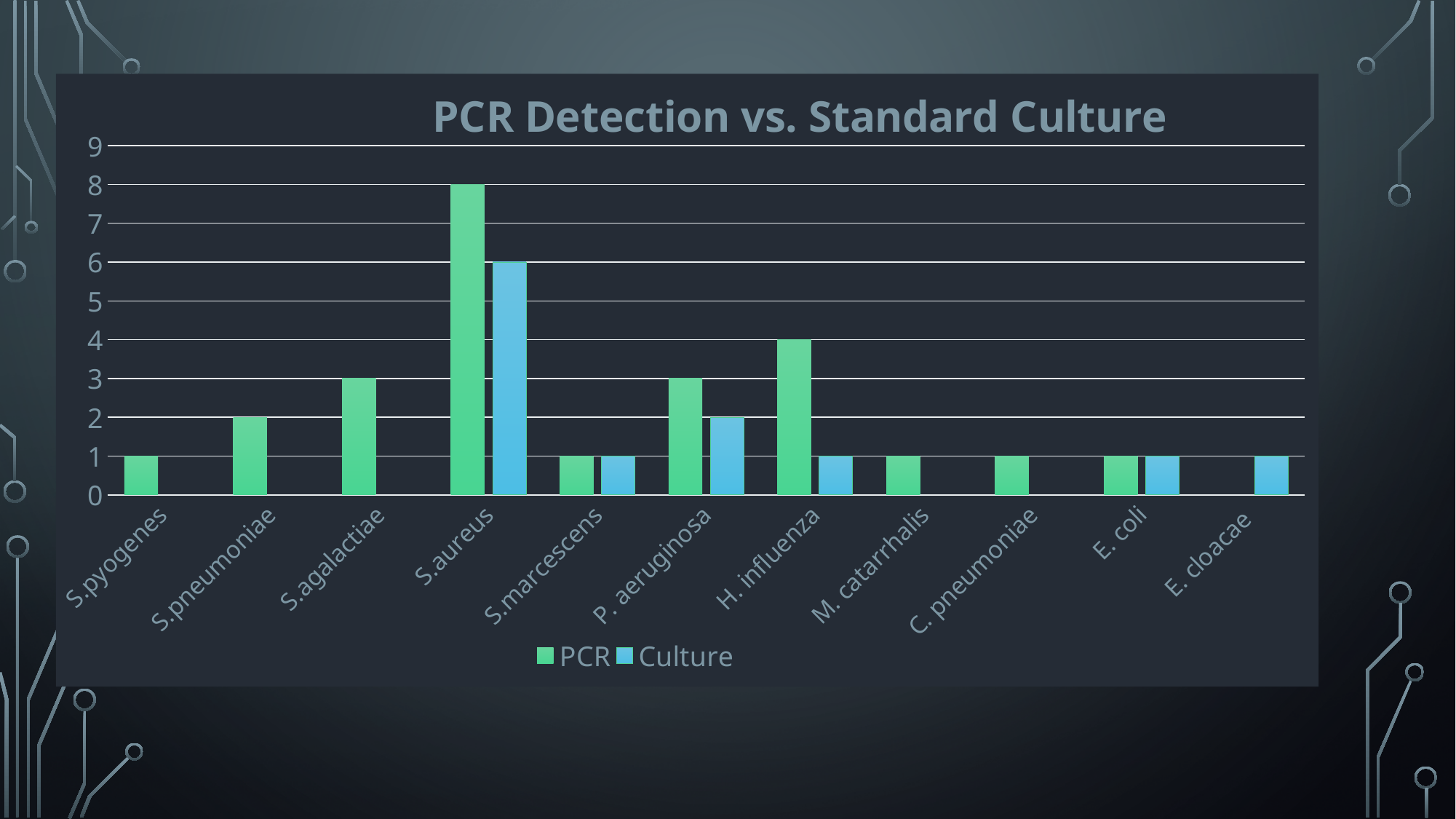
What is the title of the chart? PCR Detection vs. Standard Culture How many series does the legend list? 2 What is the PCR value for S.aureus? 8 Which is larger, the PCR value for S.agalactiae or the PCR value for S.pneumoniae? S.agalactiae What is the difference between the PCR and Culture values for S.aureus? 2 What kind of chart is shown? bar chart What is the Culture value for S.aureus? 6 Which category has the highest PCR value? S.aureus What is the PCR value for H. influenza? 4 Is the PCR value for S.aureus greater or less than 5? greater How many categories are shown on the x axis? 11 What is the Culture value for P. aeruginosa? 2